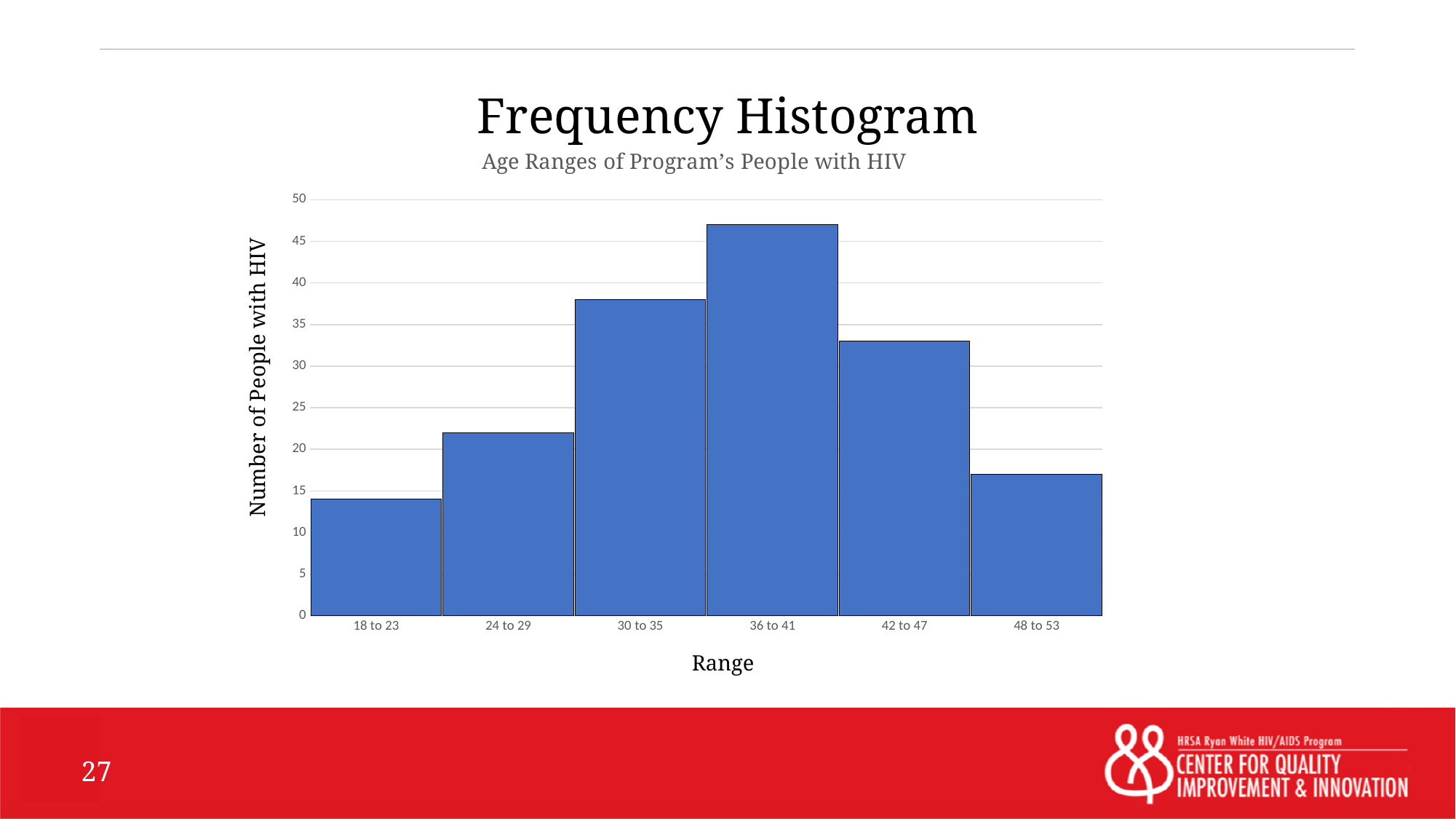
Which has a larger value, the 30 to 35 range or the 42 to 47 range? 30 to 35 Which age range has the lowest number of people with HIV? 18 to 23 Is the value for the 42 to 47 range greater or less than 35? less Which has a larger value, the 24 to 29 range or the 48 to 53 range? 24 to 29 What kind of chart is shown on the slide? bar chart Do the values rise or fall from the 18 to 23 range through the 36 to 41 range? rise How many age range categories are plotted on the x axis? 6 What is the label of the vertical axis? Number of People with HIV Is the value for the 36 to 41 range greater or less than 45? greater Is the value for the 18 to 23 range greater or less than 10? greater Which age range has the highest number of people with HIV? 36 to 41